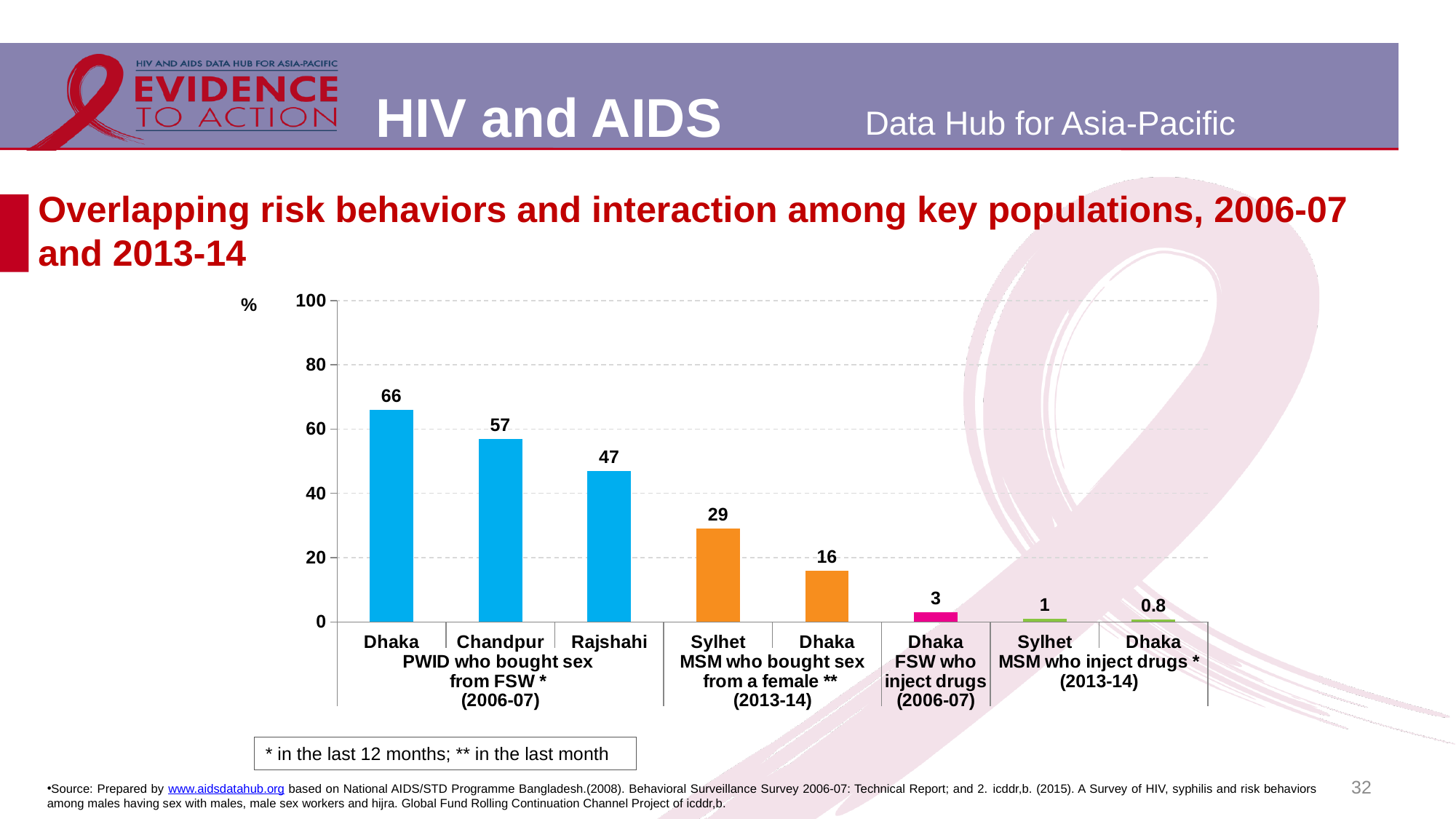
What is the difference between the Dhaka and Rajshahi values in the 'PWID who bought sex from FSW (2006-07)' group? 19 How many bars are plotted on the chart? 8 What kind of chart is shown on the slide? Bar chart What is the value for Chandpur in the 'PWID who bought sex from FSW (2006-07)' group? 57 Which bar has the highest value on the chart? Dhaka (PWID who bought sex from FSW, 2006-07) Which bar has the lowest value on the chart? Dhaka (MSM who inject drugs, 2013-14) Is the value for Rajshahi in the 'PWID who bought sex from FSW (2006-07)' group greater or less than 40? greater What is the value for Dhaka in the 'PWID who bought sex from FSW (2006-07)' group? 66 Which is larger: the Sylhet value for 'MSM who bought sex from a female' or the Dhaka value for 'MSM who bought sex from a female'? Sylhet What is the value for Dhaka in the 'FSW who inject drugs (2006-07)' group? 3 What is the value for Sylhet in the 'MSM who bought sex from a female (2013-14)' group? 29 What is the value for Dhaka in the 'MSM who inject drugs (2013-14)' group? 0.8